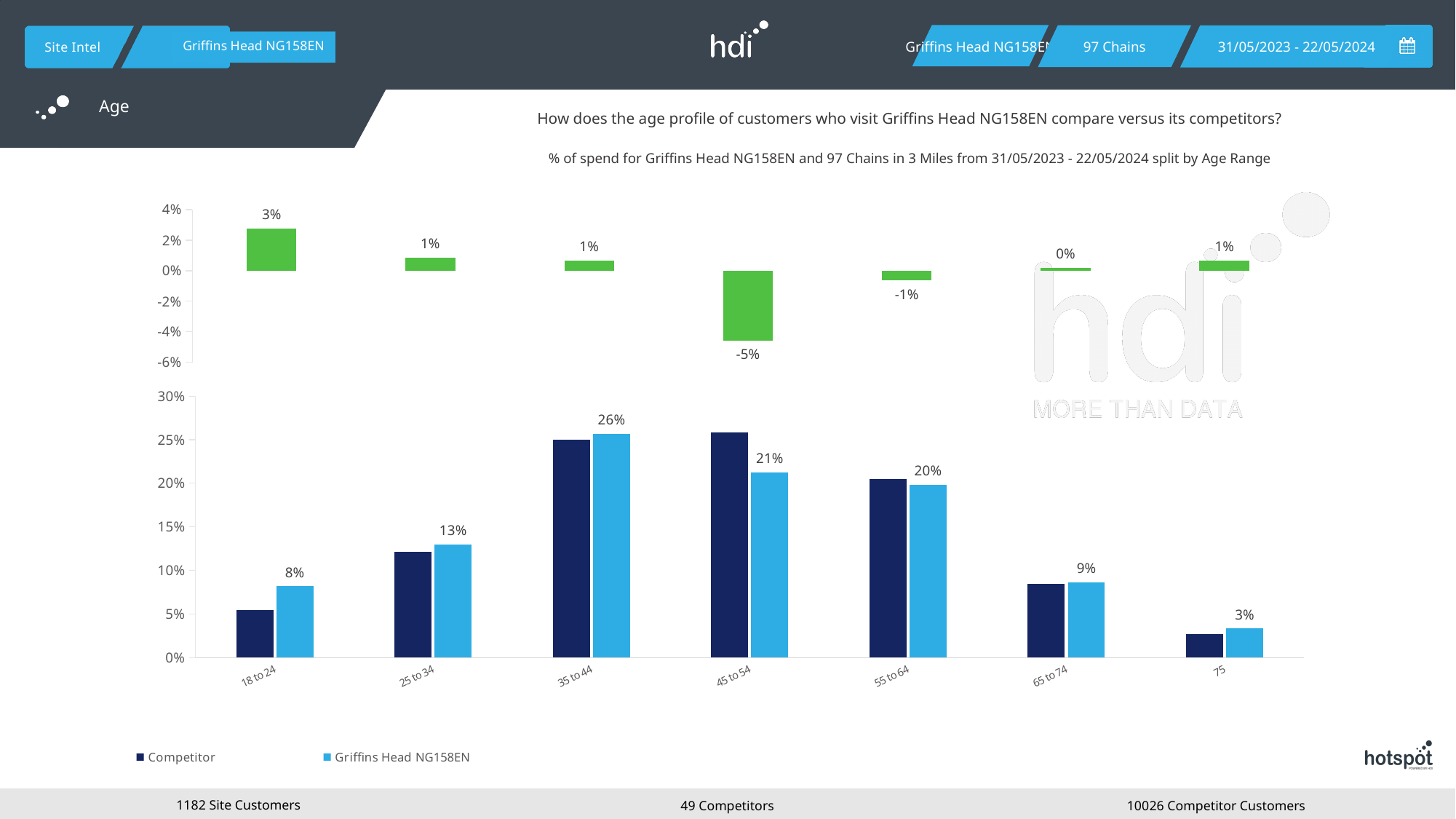
In the bottom chart, is the Competitor value for 35 to 44 greater or less than 20%? greater In the bottom chart, what is the value for Griffins Head NG158EN in the 35 to 44 age range? 26% In the bottom chart, which is larger for the 25 to 34 age range: the Competitor bar or the Griffins Head NG158EN bar? Griffins Head NG158EN In the bottom chart, is the Competitor value for 18 to 24 greater or less than 10%? less In the top chart, what is the value shown for the 45 to 54 age range? -5% What kind of chart is the bottom chart? Bar chart In the bottom chart, which age range has the lowest value for Griffins Head NG158EN? 75 How many age range categories are shown on the x axis of the bottom chart? 7 In the bottom chart, what is the difference between the Griffins Head NG158EN values for 45 to 54 and 55 to 64? 1% How many series does the legend of the bottom chart list? 2 In the bottom chart, which age range has the highest value for Griffins Head NG158EN? 35 to 44 In the bottom chart, what is the value for Griffins Head NG158EN in the 18 to 24 age range? 8%